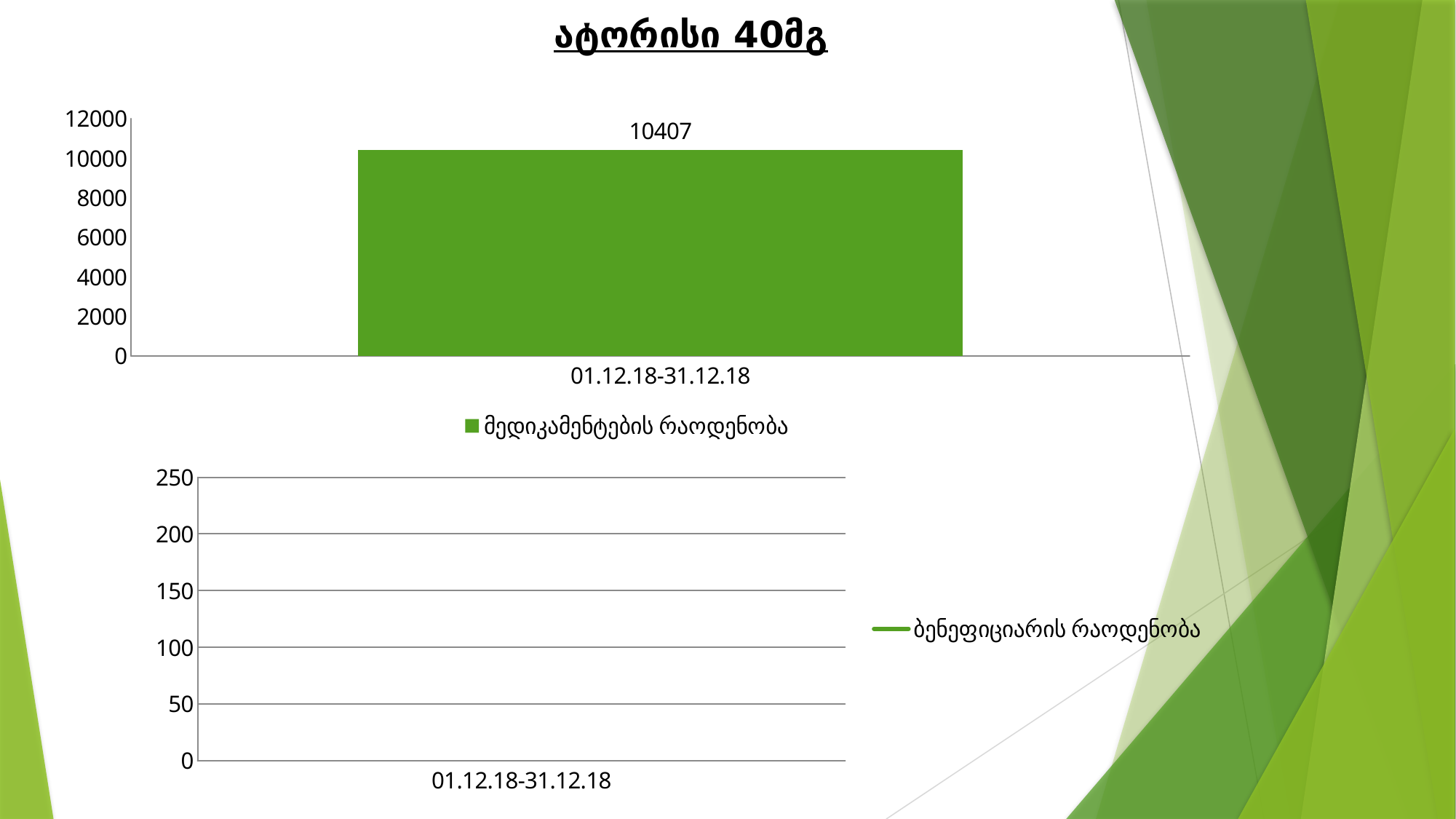
In the top chart, what is the value of the bar for 01.12.18-31.12.18? 10407 What kind of chart is the top chart on the slide? bar chart How many bars are plotted in the top chart? 1 What is the title of the slide above the charts? ატორისი 40მგ What is the legend entry of the top chart? მედიკამენტების რაოდენობა How many series does the legend of the bottom chart list? 1 How many series does the legend of the top chart list? 1 In the top chart, is the value for 01.12.18-31.12.18 greater or less than 10000? greater In the top chart, is the value for 01.12.18-31.12.18 greater or less than 12000? less What is the legend entry of the bottom chart? ბენეფიციარის რაოდენობა What is the category label on the x axis of the bottom chart? 01.12.18-31.12.18